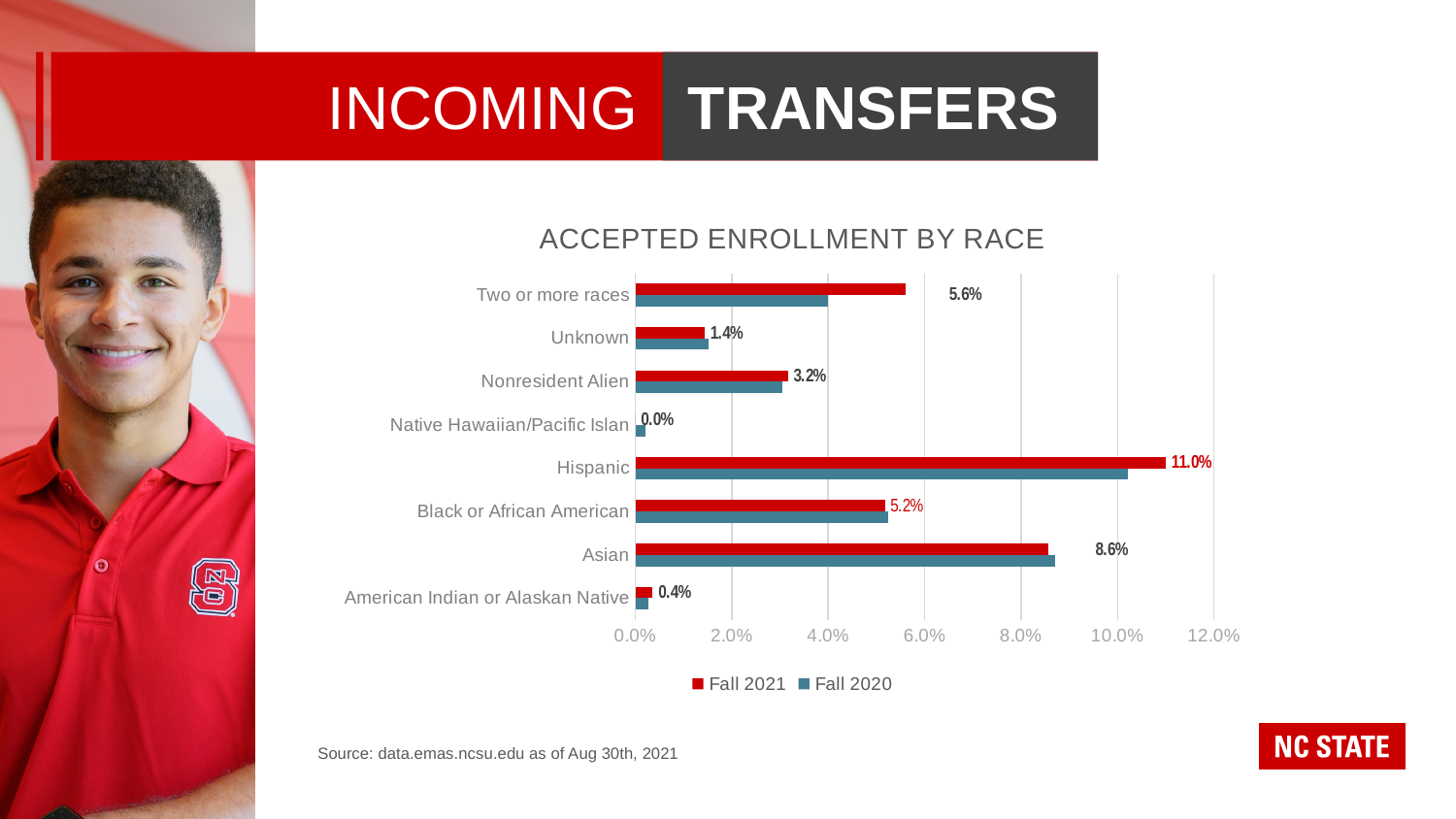
Which has the larger Fall 2021 value, Two or more races or Black or African American? Two or more races Which category has the highest Fall 2021 value? Hispanic Which category has the lowest Fall 2021 value? Native Hawaiian/Pacific Islan What is the Fall 2021 value for Hispanic? 11.0% What is the Fall 2021 value for Asian? 8.6% Is the Fall 2020 value for Nonresident Alien greater or less than 4.0%? less How many series does the legend list? 2 What is the Fall 2021 value for American Indian or Alaskan Native? 0.4% What is the Fall 2021 value for Unknown? 1.4% Is the Fall 2020 value for Asian greater or less than 8.0%? greater What is the difference between the Fall 2021 values for Hispanic and Asian? 2.4% How many race categories are shown on the chart? 8